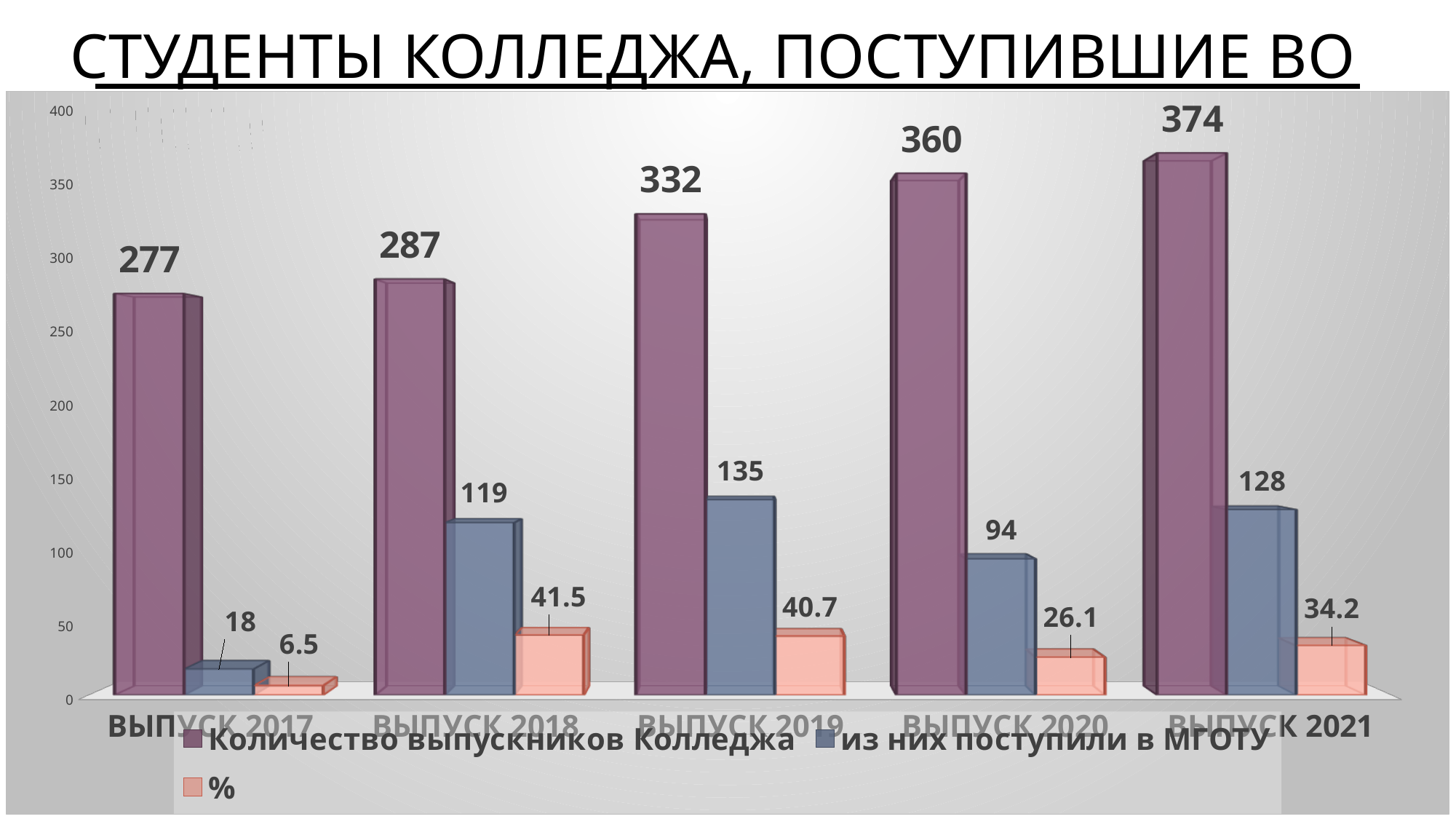
What is the difference between 'Количество выпускников Колледжа' for ВЫПУСК 2021 and ВЫПУСК 2017? 97 Which is larger: 'из них поступили в МГОТУ' for ВЫПУСК 2019 or for ВЫПУСК 2021? ВЫПУСК 2019 How many graduates 'из них поступили в МГОТУ' in ВЫПУСК 2020? 94 Which year has the highest value for 'Количество выпускников Колледжа'? ВЫПУСК 2021 Is the value for 'Количество выпускников Колледжа' in ВЫПУСК 2020 greater or less than 350? greater How many graduation years (categories) are shown on the x axis? 5 How many series does the legend list? 3 What kind of chart is shown on the slide? bar chart What is the '%' value for ВЫПУСК 2018? 41.5 Does the 'Количество выпускников Колледжа' series rise or fall from ВЫПУСК 2017 to ВЫПУСК 2021? rise Which year has the lowest value for 'из них поступили в МГОТУ'? ВЫПУСК 2017 What is the value of 'Количество выпускников Колледжа' for ВЫПУСК 2019? 332